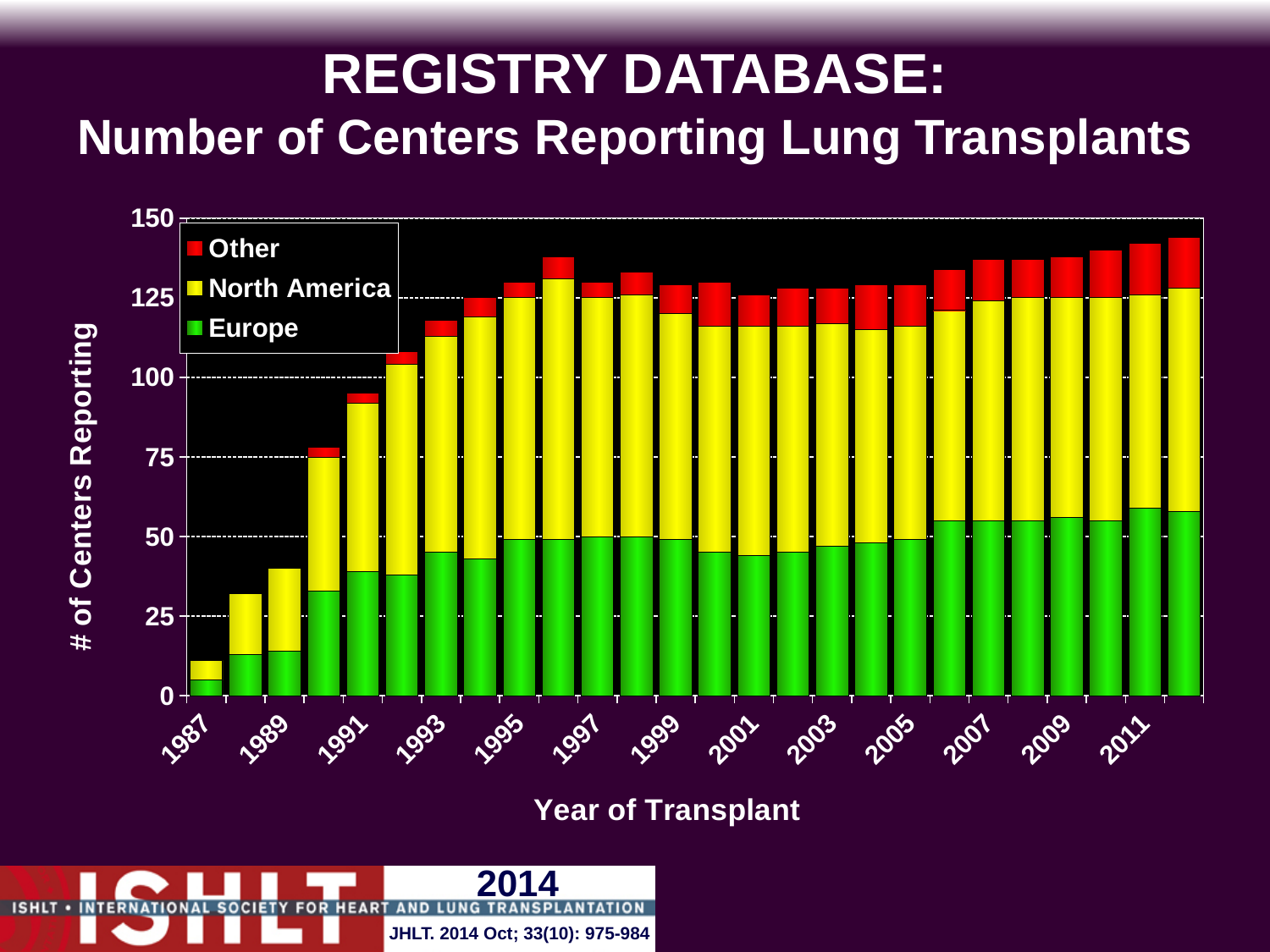
What kind of chart is shown on the slide? Stacked bar chart Is the number of Europe centers reporting in 1989 greater or less than 25? less Which year has the lowest total number of centers reporting? 1987 Is the total number of centers reporting in 1993 greater or less than 100? greater How many series does the legend list? 3 Does the total number of centers reporting generally rise or fall from 1987 to 2011? rise Is the total number of centers reporting in 2011 greater or less than 125? greater In 2011, which series has more centers reporting, Europe or North America? North America What colour represents Europe in the chart? Green Which year has a higher total number of centers reporting, 1989 or 1991? 1991